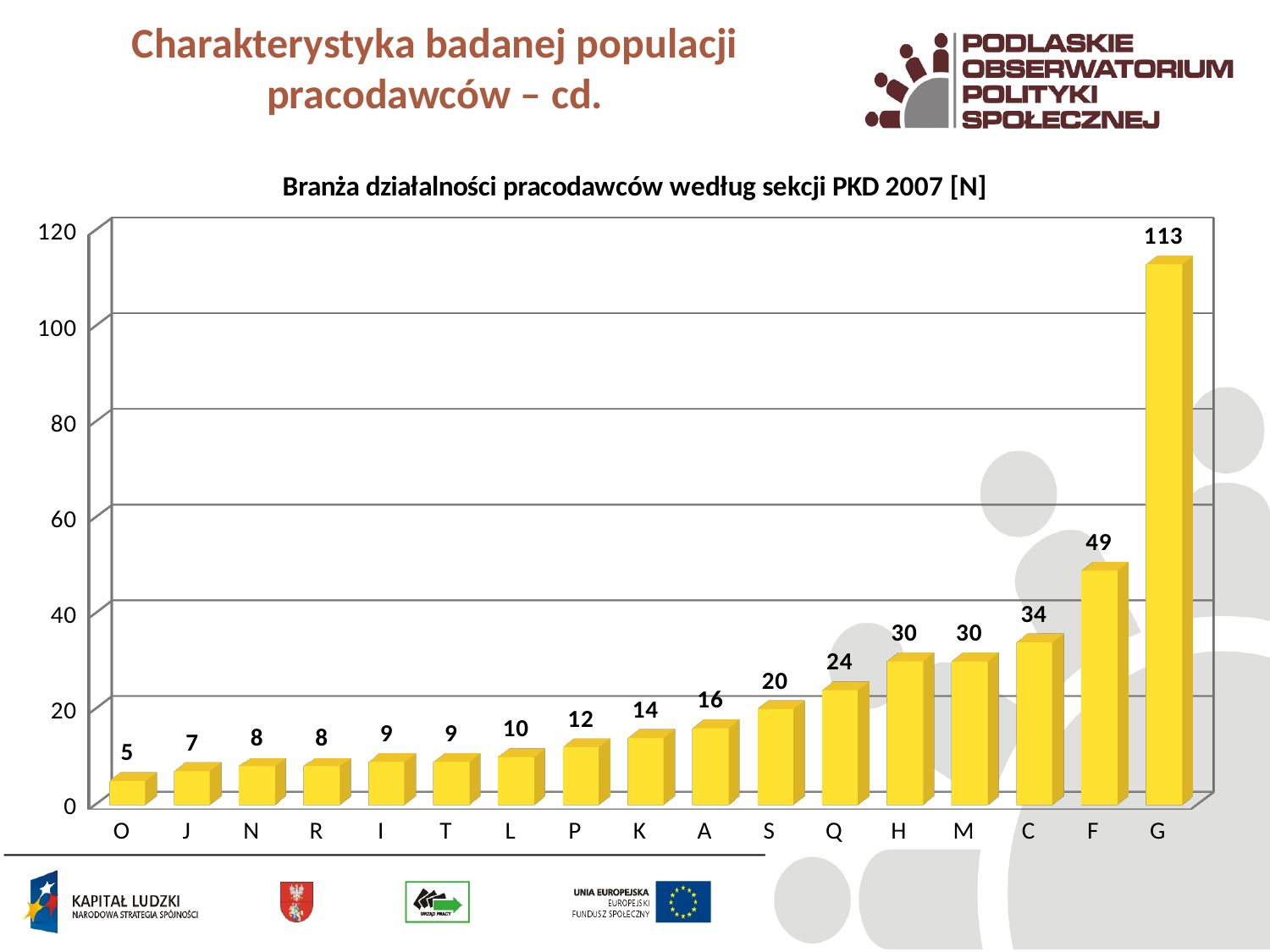
Which section has the lowest value? O Which section has the highest value? G What kind of chart is shown on the slide? bar chart Which is larger, the value for C or the value for K? C Is the value for section G greater or less than 100? greater What is the difference between the values for G and F? 64 What is the value for section F? 49 How many sections (categories) are shown on the x axis? 17 What is the value for section G? 113 What is the value for section Q? 24 What is the title of the chart? Branża działalności pracodawców według sekcji PKD 2007 [N] What is the value for section O? 5